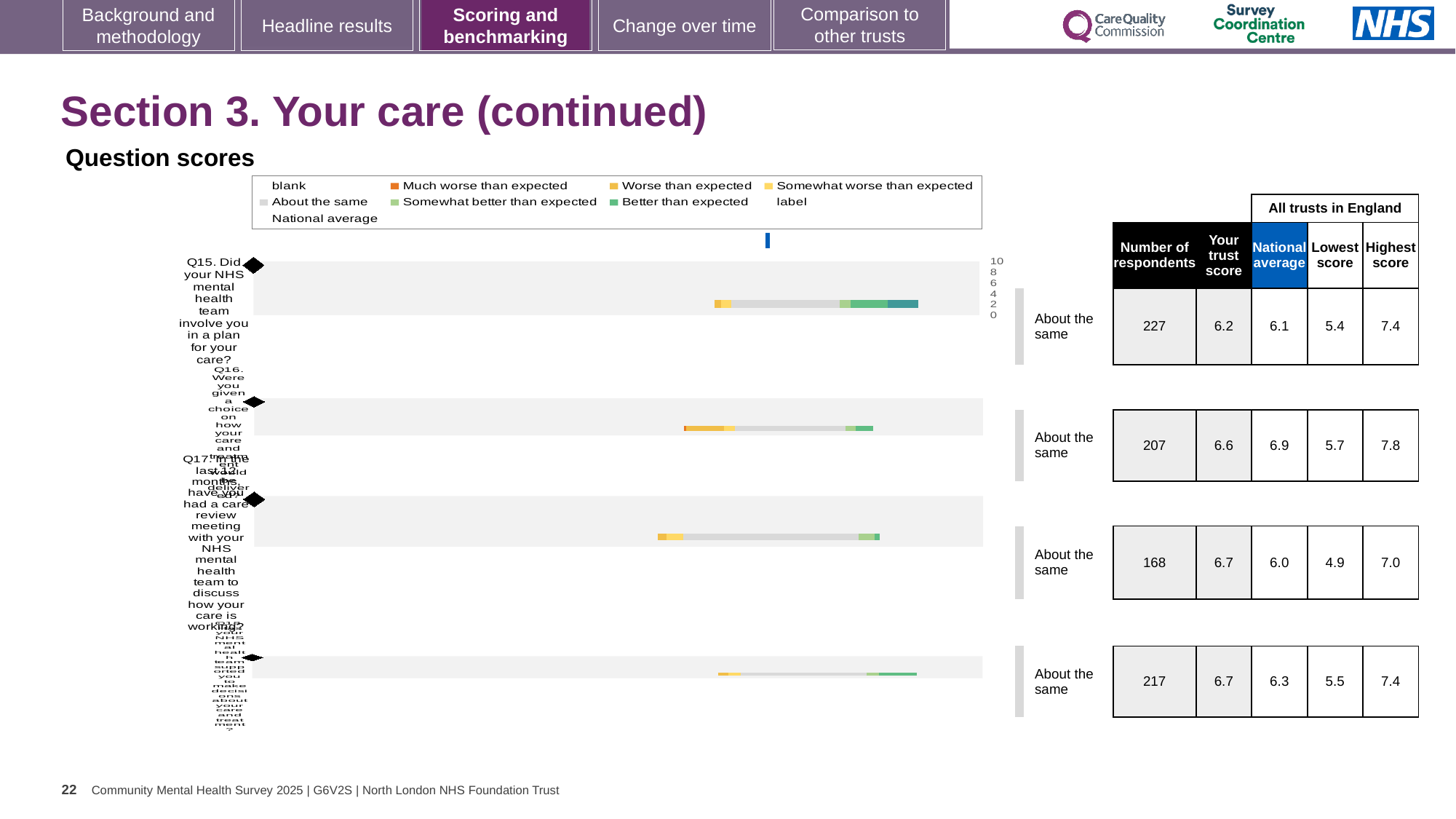
In the question scores chart, what colour represents 'Much worse than expected' in the legend? orange For the second row (Q16), which is larger: the trust score or the national average? National average (6.9) What is the difference between the trust score and the national average for Q15? 0.1 What is the trust score for Q15 (Did your NHS mental health team involve you in a plan for your care?)? 6.2 Which row has the highest number of respondents? Q15 (227) What is the number of respondents for Q15 (Did your NHS mental health team involve you in a plan for your care?)? 227 What is the highest score among all trusts in England for the second row (Q16)? 7.8 How many questions (bars) are plotted in the question scores chart? 4 Which row has the lowest number of respondents? Q17, the third row (168) What is the lowest score among all trusts in England for the third row (Q17)? 4.9 What is the national average for Q17 (care review meeting with your NHS mental health team), the third row? 6.0 What kind of chart is used to show the question scores on this slide? bar chart